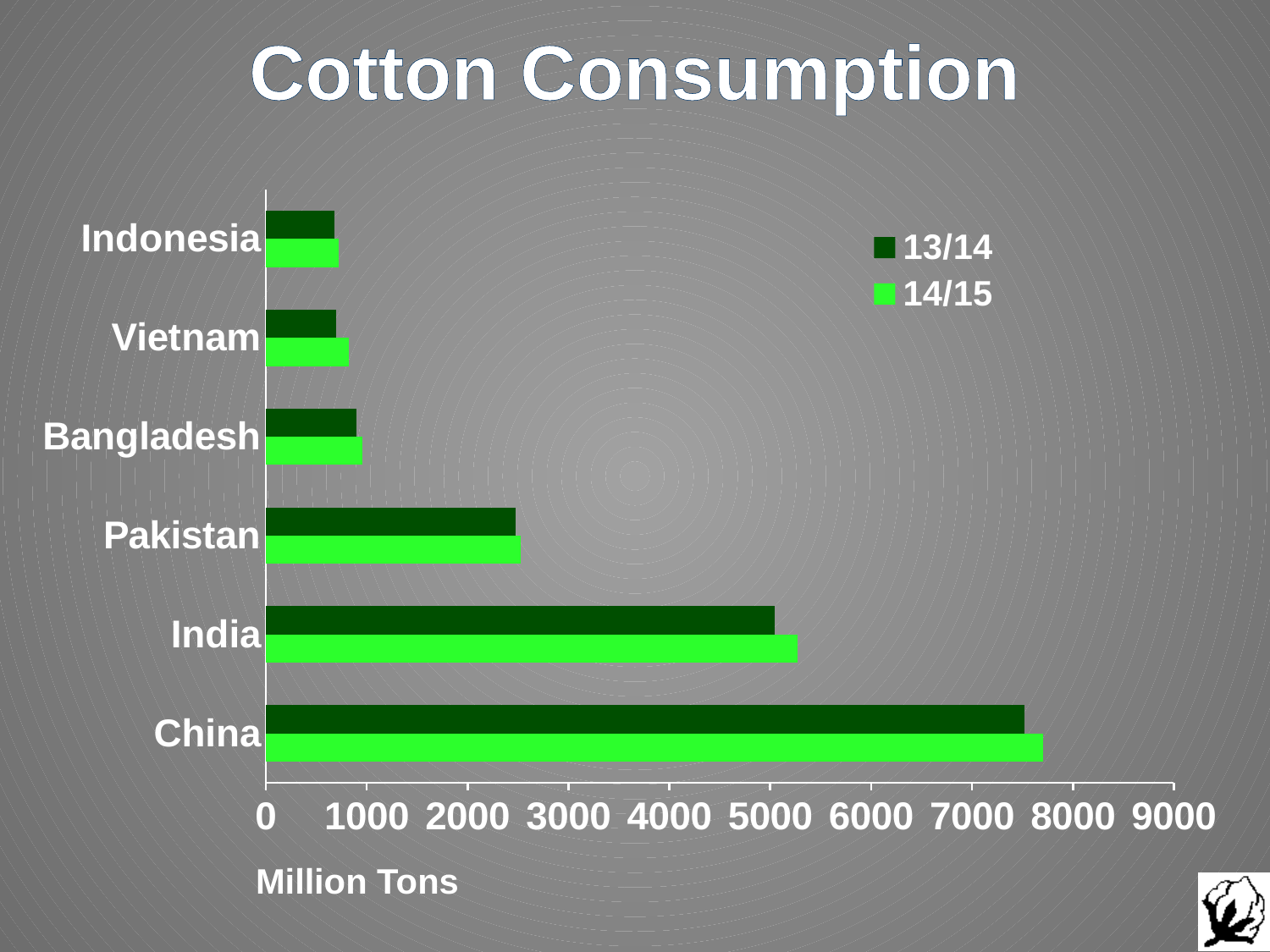
Is the 14/15 value for China greater or less than 7000? greater How many series does the legend list? 2 What is the label on the horizontal axis? Million Tons Which country has the highest cotton consumption in 14/15? China What kind of chart is shown on the slide? bar chart Is the 13/14 value for Bangladesh greater or less than 1000? less How many countries are shown on the chart? 6 Is the 13/14 value for India greater or less than 4000? greater Which country has the highest cotton consumption in 13/14? China What are the two series listed in the legend? 13/14 and 14/15 Which is larger, the 14/15 value for India or the 14/15 value for Pakistan? India